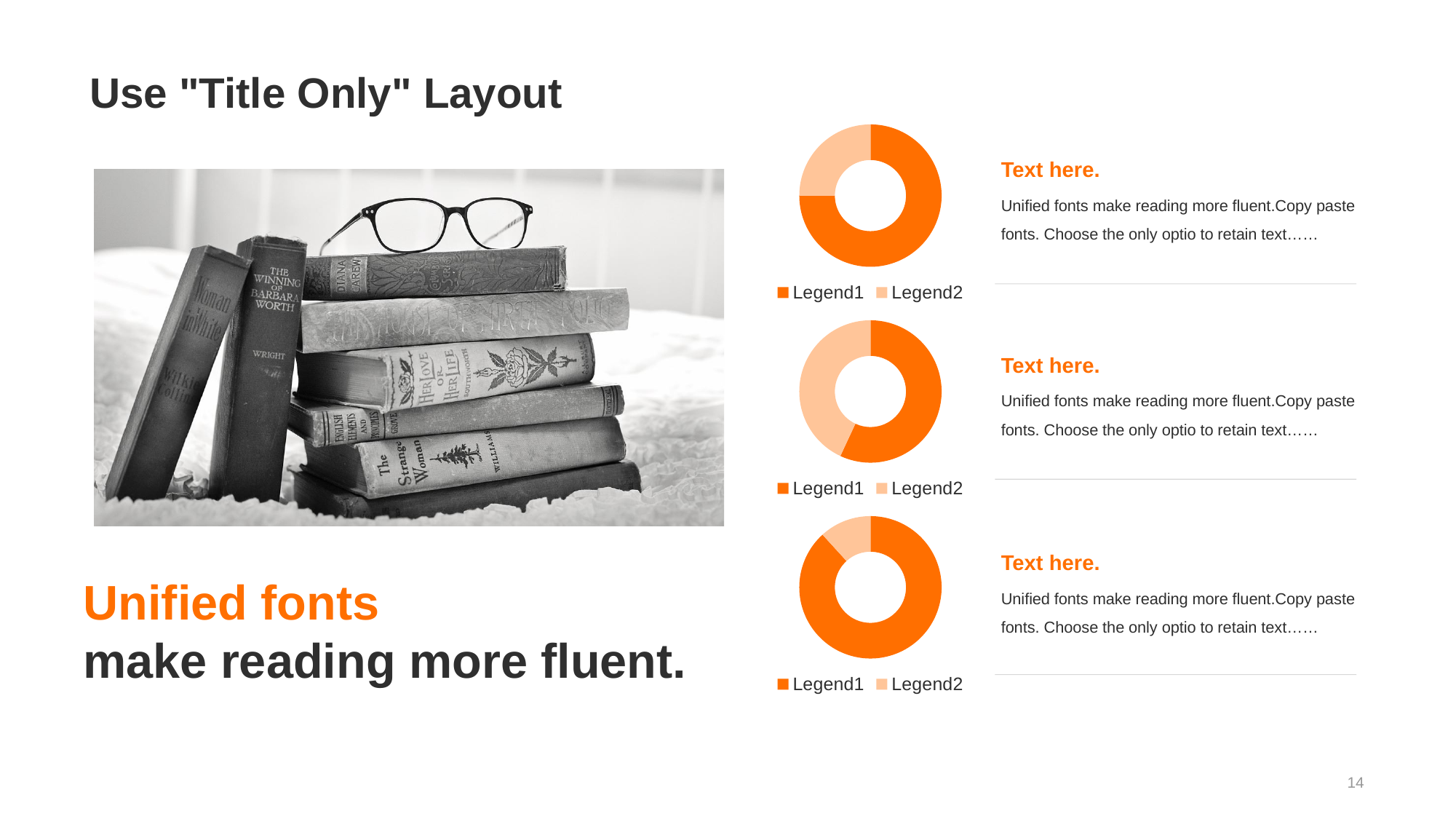
How many series does the legend of the top chart list? 2 In the bottom chart, which slice is larger, Legend1 or Legend2? Legend1 What are the two legend entries of the middle chart? Legend1 and Legend2 In the bottom chart, which slice is the smallest? Legend2 What kind of chart is the top chart on the right side of the slide? Doughnut chart Which of the three charts has the smallest Legend2 slice? The bottom chart How many slices does the bottom chart have? 2 What colour represents Legend1 in the charts? Orange How many doughnut charts are on the slide? 3 In the top chart, which slice is larger, Legend1 or Legend2? Legend1 In the middle chart, which slice is the largest? Legend1